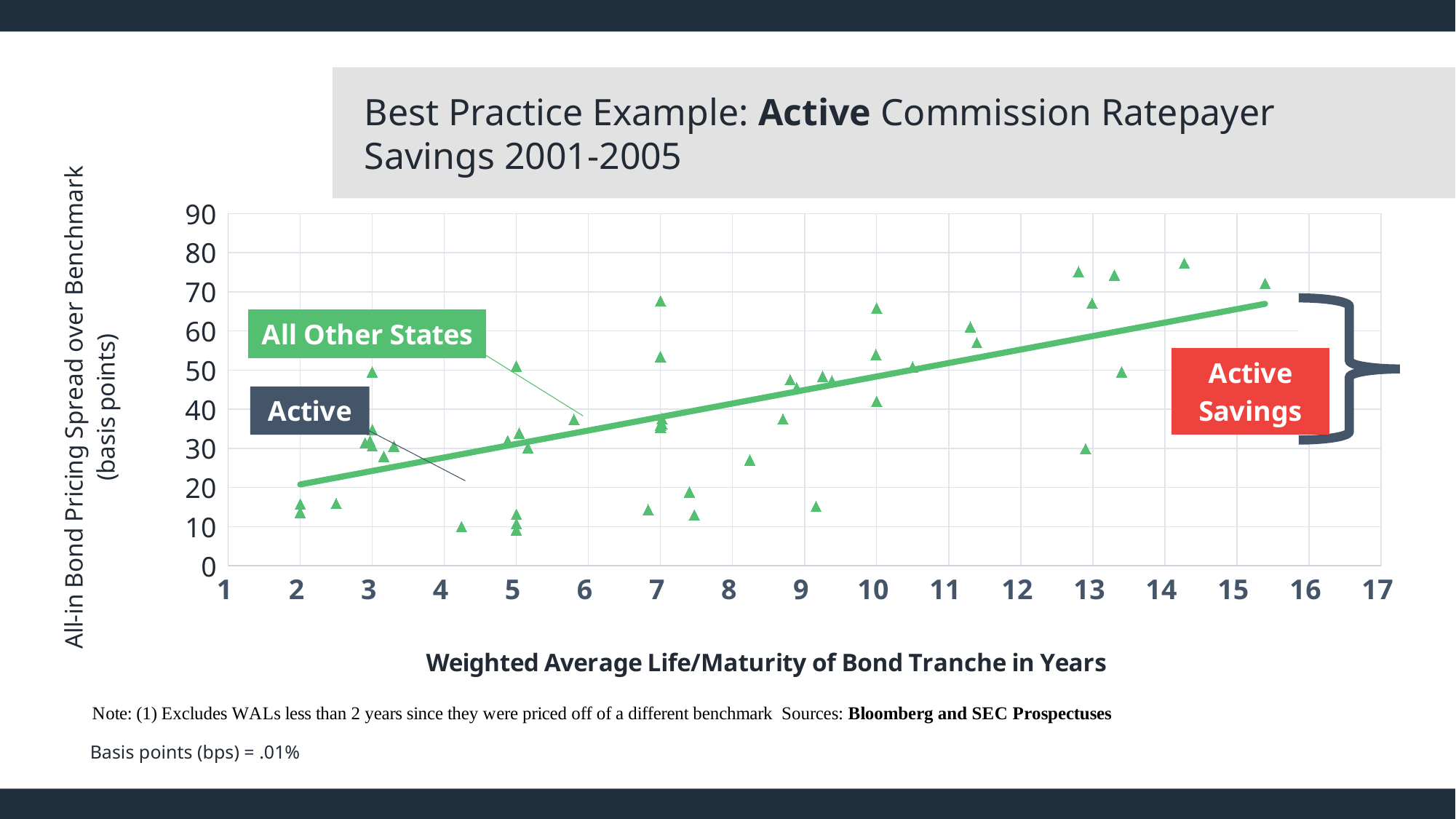
What kind of chart is shown on the slide? scatter chart Is the value of the Active line at 2 years greater or less than 30? less How many series are labelled on the chart? 2 Is the highest All Other States point greater or less than 70? greater Does the Active trend line rise or fall as the weighted average life increases? rises What is the label of the x axis? Weighted Average Life/Maturity of Bond Tranche in Years Is the lowest All Other States point greater or less than 20? less Which is larger: the Active line value at 15 years or at 2 years? at 15 years What is the maximum value shown on the y axis? 90 What is the title of the chart? Best Practice Example: Active Commission Ratepayer Savings 2001-2005